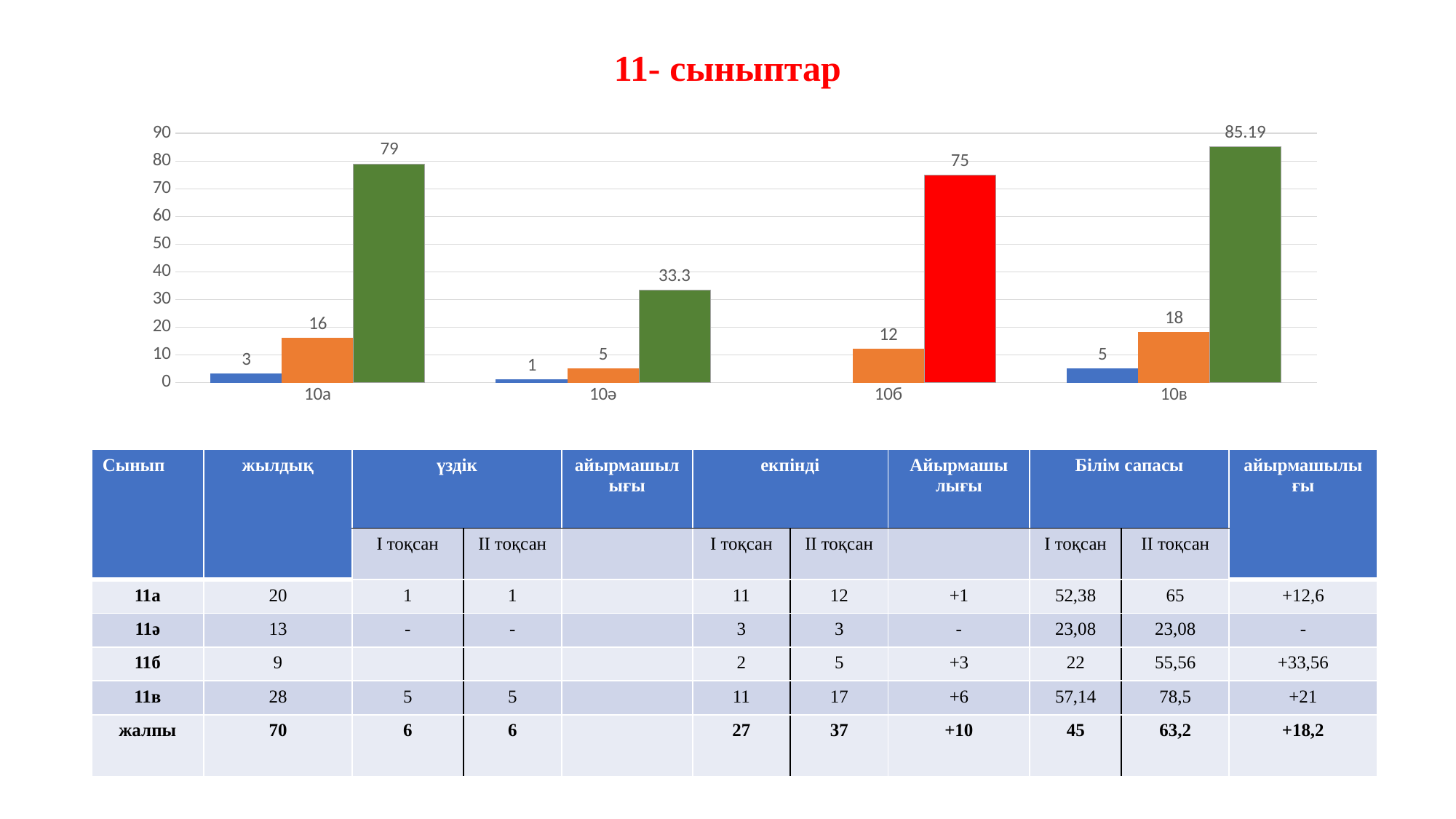
What type of chart is shown on the slide? bar chart Which category has the lowest blue bar? 10ә What is the value of the green bar for 10а? 79 What is the difference between the orange bars for 10в and 10а? 2 How many categories are shown on the x axis of the chart? 4 What is the value of the tallest bar for 10в? 85.19 Which category has the highest bar in the chart? 10в What is the value of the orange bar for 10ә? 5 Which is larger: the green bar for 10а or the red bar for 10б? 10а What is the value of the red bar for 10б? 75 What is the highest value shown on the chart's vertical axis? 90 Is the tallest bar for 10ә greater or less than 40? less